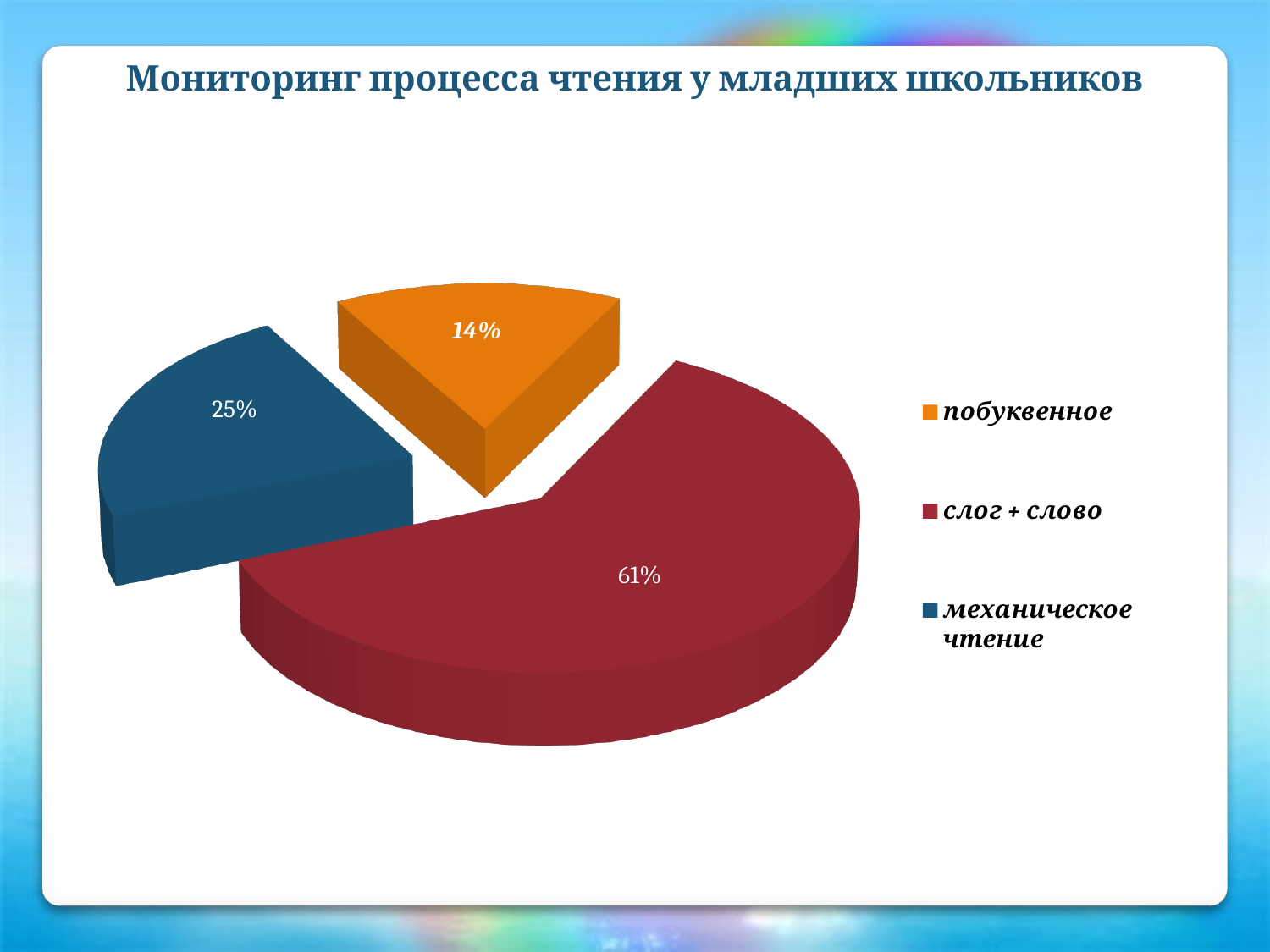
Which category has the smallest slice of the pie? побуквенное What is the title of the slide? Мониторинг процесса чтения у младших школьников What share of the pie does "побуквенное" have? 14% Which category has the largest slice of the pie? слог + слово What share of the pie does "механическое чтение" have? 25% Which is larger, the slice for "механическое чтение" or the slice for "побуквенное"? механическое чтение What kind of chart is shown on the slide? pie chart What colour is the slice for "побуквенное"? orange What share of the pie does "слог + слово" have? 61% How many slices does the pie chart have? 3 What is the difference in percentage points between "механическое чтение" and "побуквенное"? 11 What is the difference in percentage points between "слог + слово" and "механическое чтение"? 36